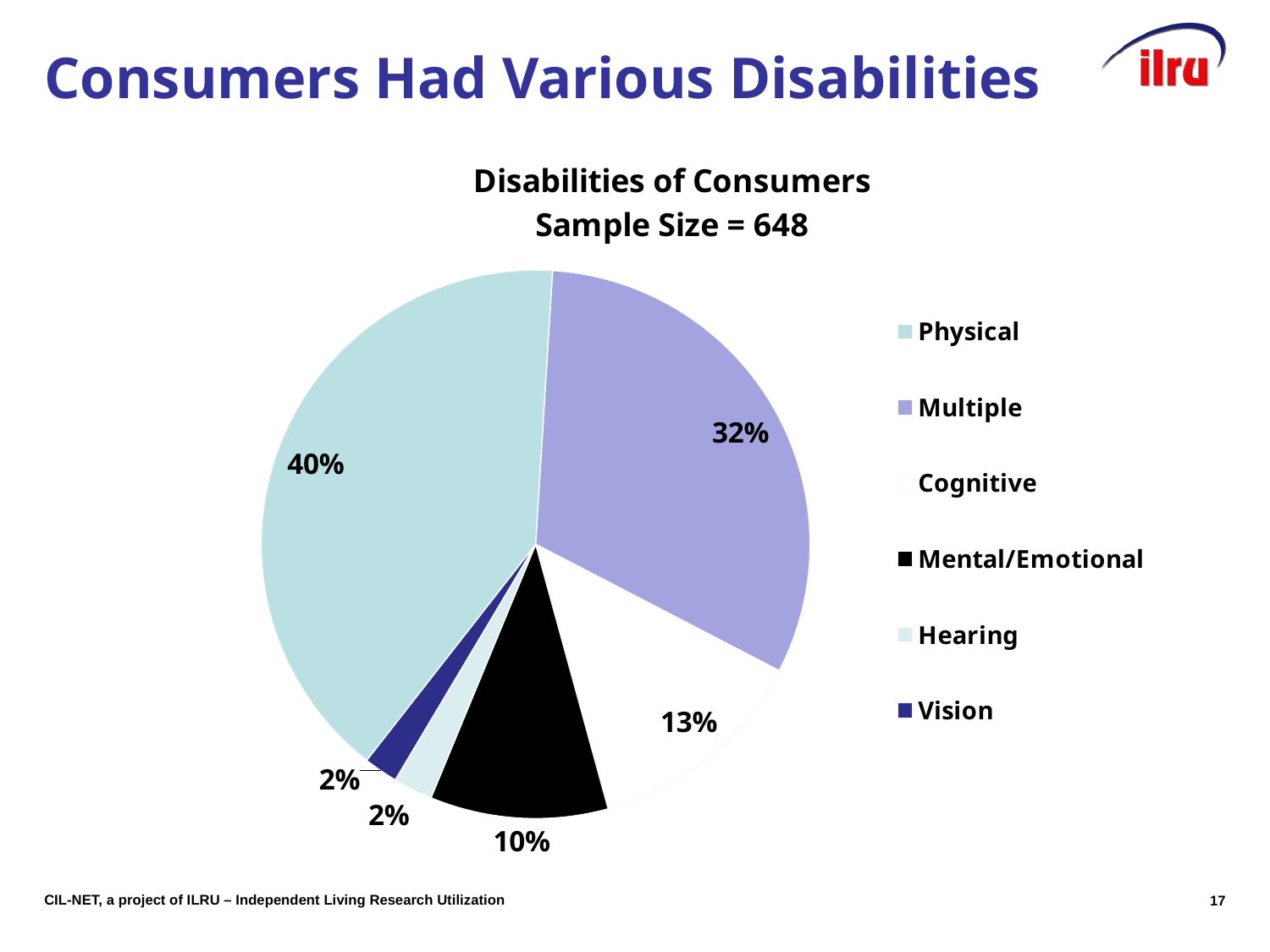
What is the value shown for Cognitive? 13% How many categories does the legend list? 6 Which category is shown in black in the pie chart? Mental/Emotional What percentage of the pie is the Multiple slice? 32% What is the combined percentage of the Hearing and Vision slices? 4% Which of the two is larger, the Cognitive slice or the Mental/Emotional slice? Cognitive What share of consumers had a physical disability? 40% What is the difference in percentage points between the Physical and Multiple slices? 8 Which disability category has the largest slice of the pie? Physical What kind of chart is shown on the slide? Pie chart What percentage is shown for Mental/Emotional? 10% What is the sample size stated in the chart title? 648